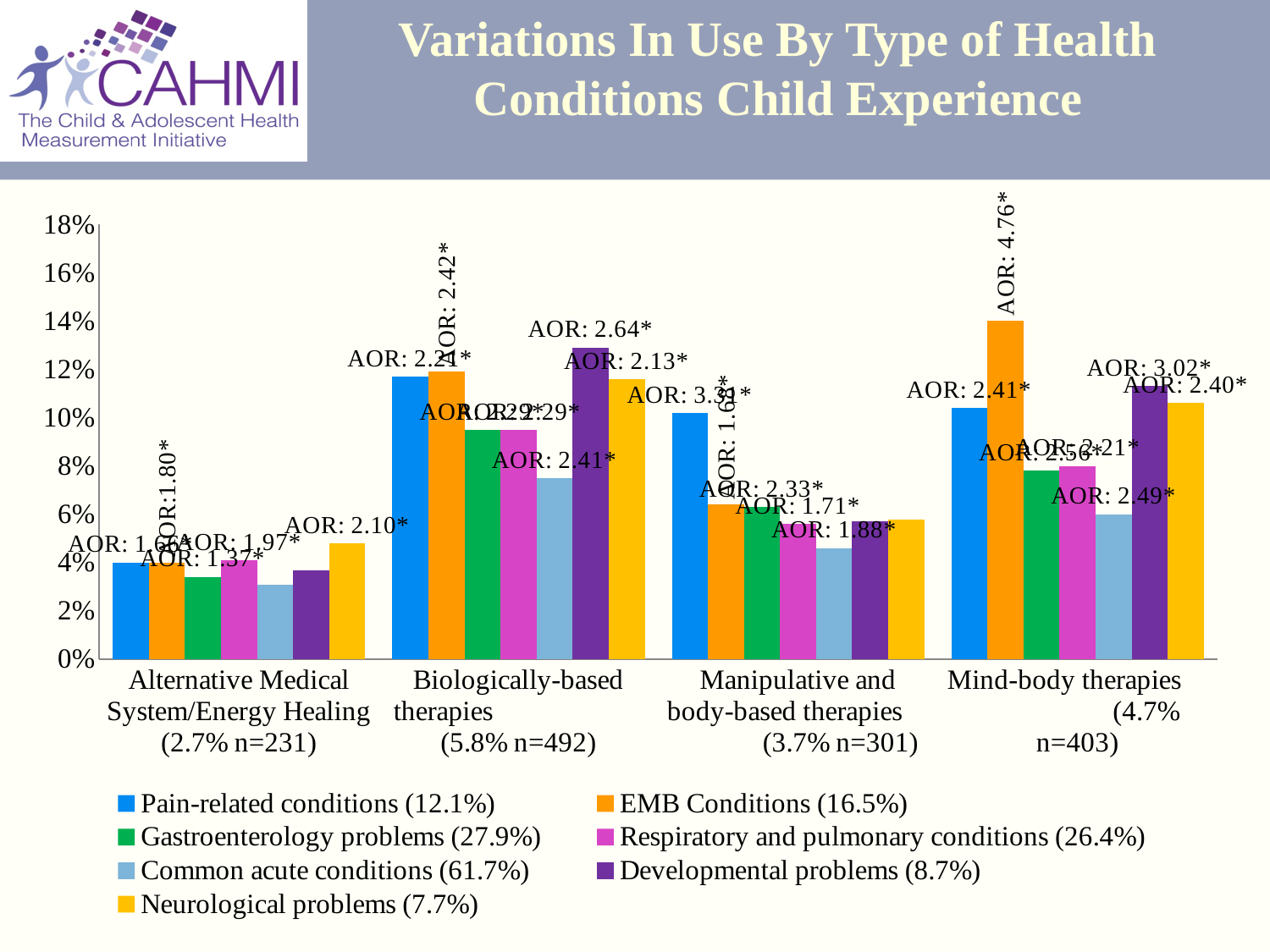
What is the title of the chart on the slide? Variations In Use By Type of Health Conditions Child Experience Is the value for Common acute conditions in the Alternative Medical System/Energy Healing group greater or less than 4%? less Is the value for Pain-related conditions in the Manipulative and body-based therapies group greater or less than 8%? greater What kind of chart is shown on the slide? bar chart In the Mind-body therapies group, which is larger: the bar for Developmental problems or the bar for Common acute conditions? Developmental problems In the Manipulative and body-based therapies group, which is larger: the bar for Pain-related conditions or the bar for EMB Conditions? Pain-related conditions Which series has the lowest bar in the Biologically-based therapies group? Common acute conditions (61.7%) Which series has the highest bar in the Manipulative and body-based therapies group? Pain-related conditions (12.1%) Which series has the highest bar in the Mind-body therapies group? EMB Conditions (16.5%) Is the value for EMB Conditions in the Mind-body therapies group greater or less than 12%? greater How many series does the legend list? 7 How many therapy categories are shown along the x axis? 4